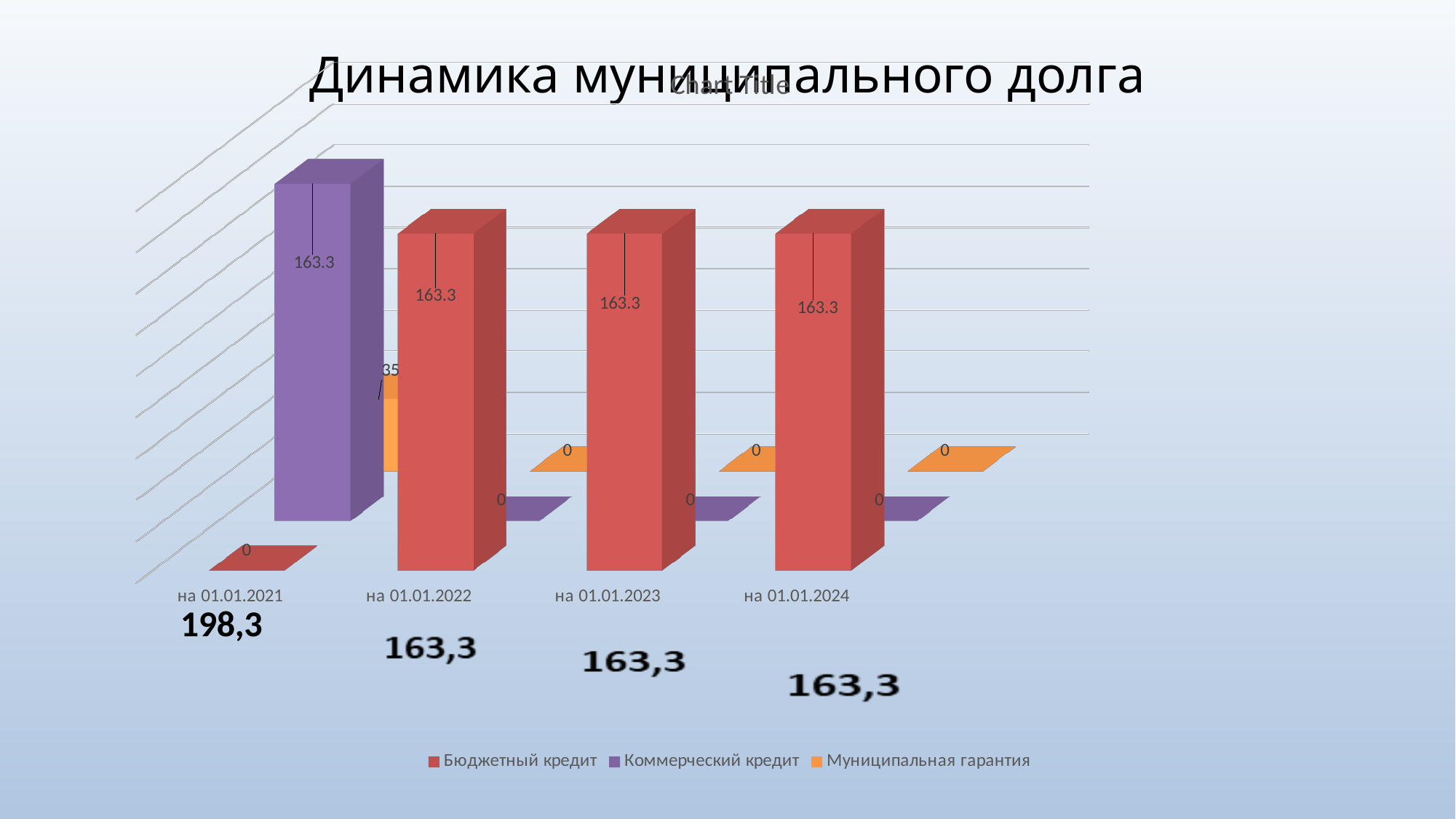
What is the value of Бюджетный кредит for на 01.01.2022? 163.3 How many series does the legend list? 3 What is the value of Бюджетный кредит for на 01.01.2021? 0 Which series has the highest value for на 01.01.2023? Бюджетный кредит What is the difference between Коммерческий кредит and Муниципальная гарантия for на 01.01.2021? 128.3 Which is larger for на 01.01.2021: Коммерческий кредит or Муниципальная гарантия? Коммерческий кредит How many categories are shown on the x axis? 4 What kind of chart is shown on the slide? bar chart What is the value of Коммерческий кредит for на 01.01.2021? 163.3 What colour represents Муниципальная гарантия in the legend? orange What is the value of Коммерческий кредит for на 01.01.2024? 0 What is the value of Муниципальная гарантия for на 01.01.2021? 35